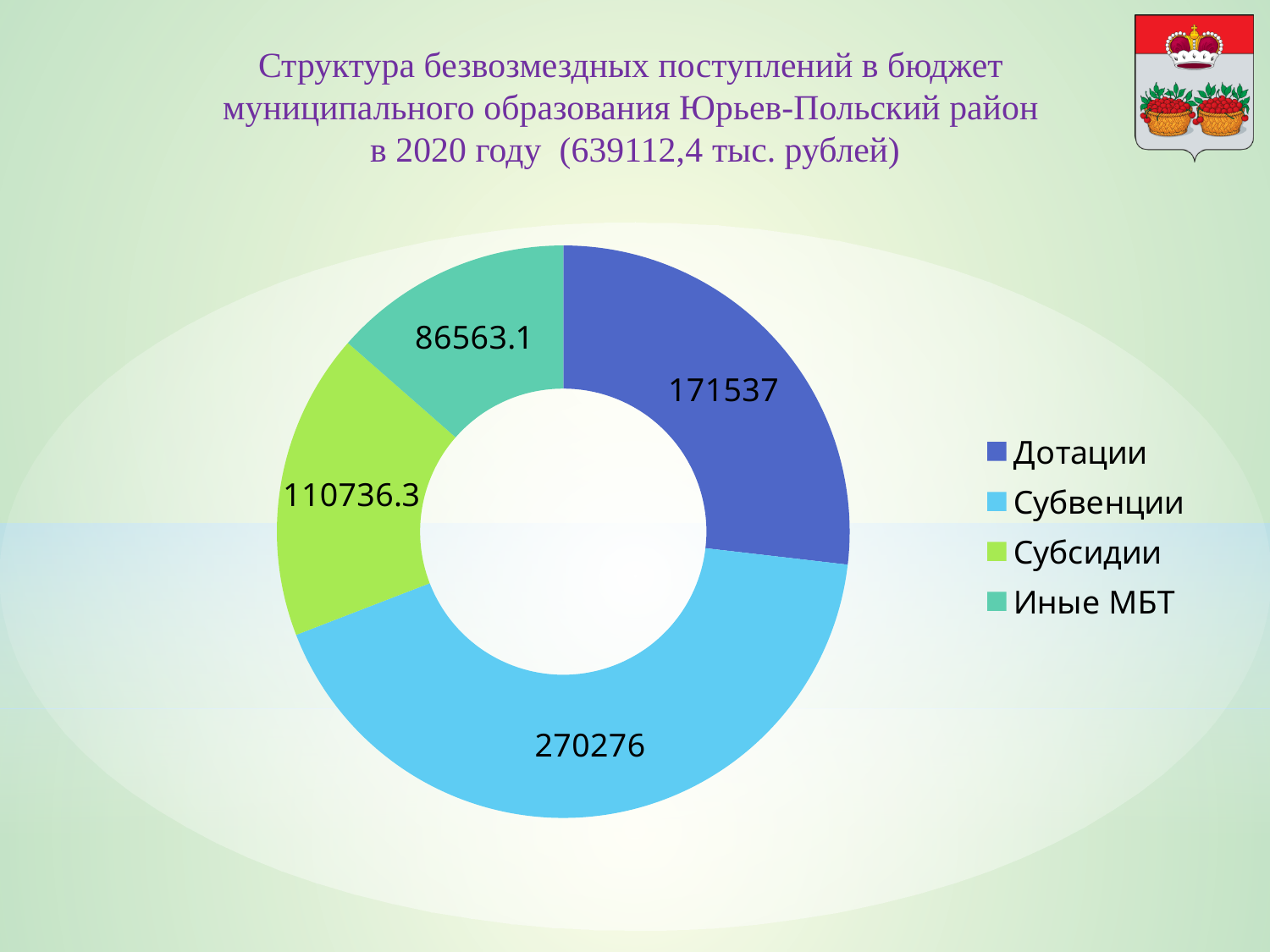
Which legend entry is shown in light green? Субсидии What kind of chart is shown on the slide? doughnut chart What is the value for Субвенции? 270276 How many categories does the chart show? 4 What is the value for Иные МБТ? 86563.1 What is the value for Дотации? 171537 Which category has the smallest value? Иные МБТ Which is larger, the value for Дотации or the value for Субсидии? Дотации What is the value for Субсидии? 110736.3 Which category has the largest value? Субвенции What is the difference between the values for Субвенции and Дотации? 98739 What is the difference between the values for Субсидии and Иные МБТ? 24173.2